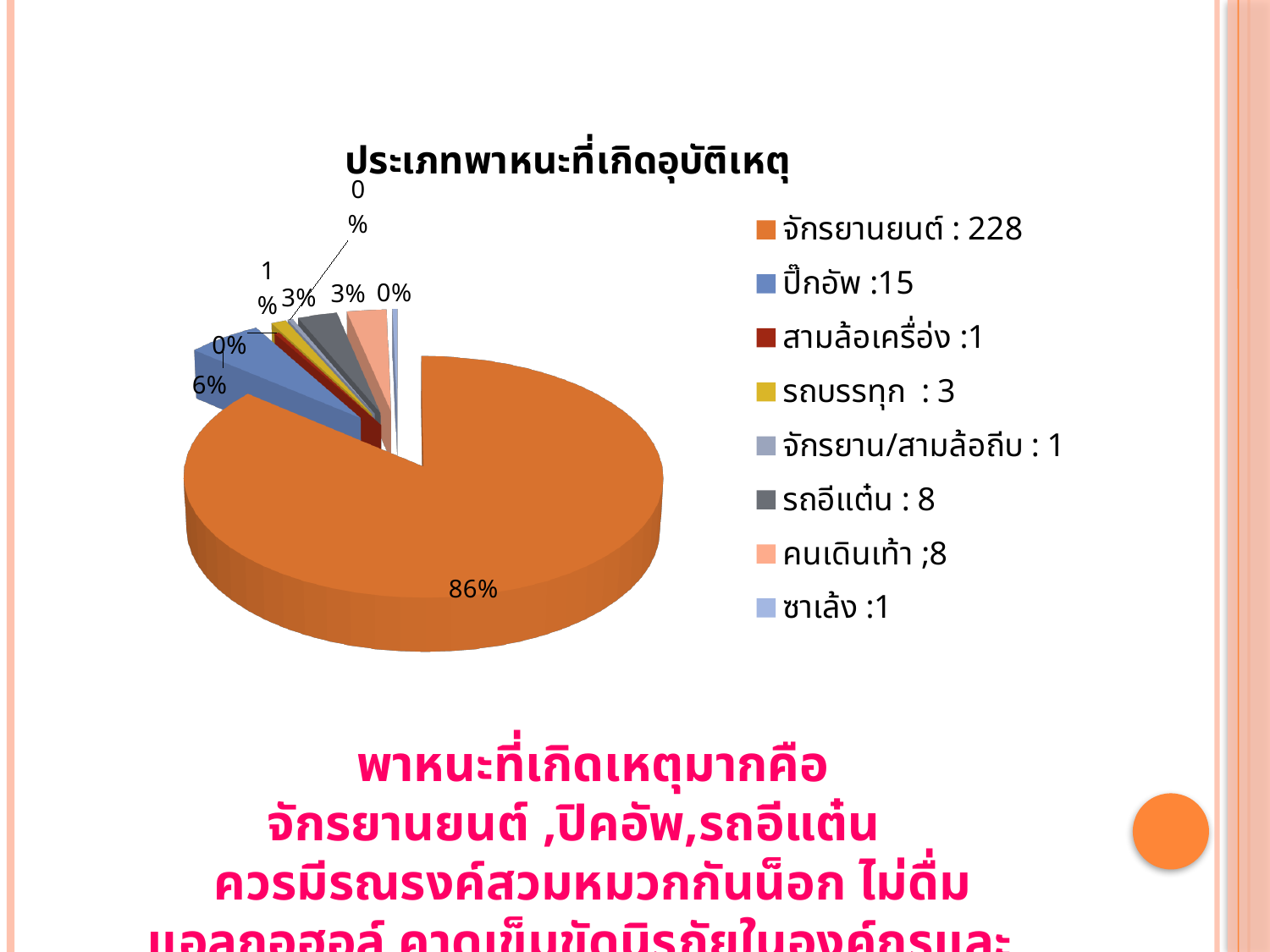
Which has a larger value, ปิ๊กอัพ or รถบรรทุก? ปิ๊กอัพ What share of the pie does ปิ๊กอัพ take? 6% What is the title of the chart? ประเภทพาหนะที่เกิดอุบัติเหตุ According to the legend, how many accidents involved จักรยานยนต์? 228 What kind of chart is shown on the slide? pie chart How many categories does the legend of the pie chart list? 8 What share of the pie does จักรยานยนต์ take? 86% What is the difference between the values for จักรยานยนต์ and ปิ๊กอัพ shown in the legend? 213 What share of the pie does รถบรรทุก take? 1% Which category has the largest slice of the pie? จักรยานยนต์ According to the legend, how many accidents involved ปิ๊กอัพ? 15